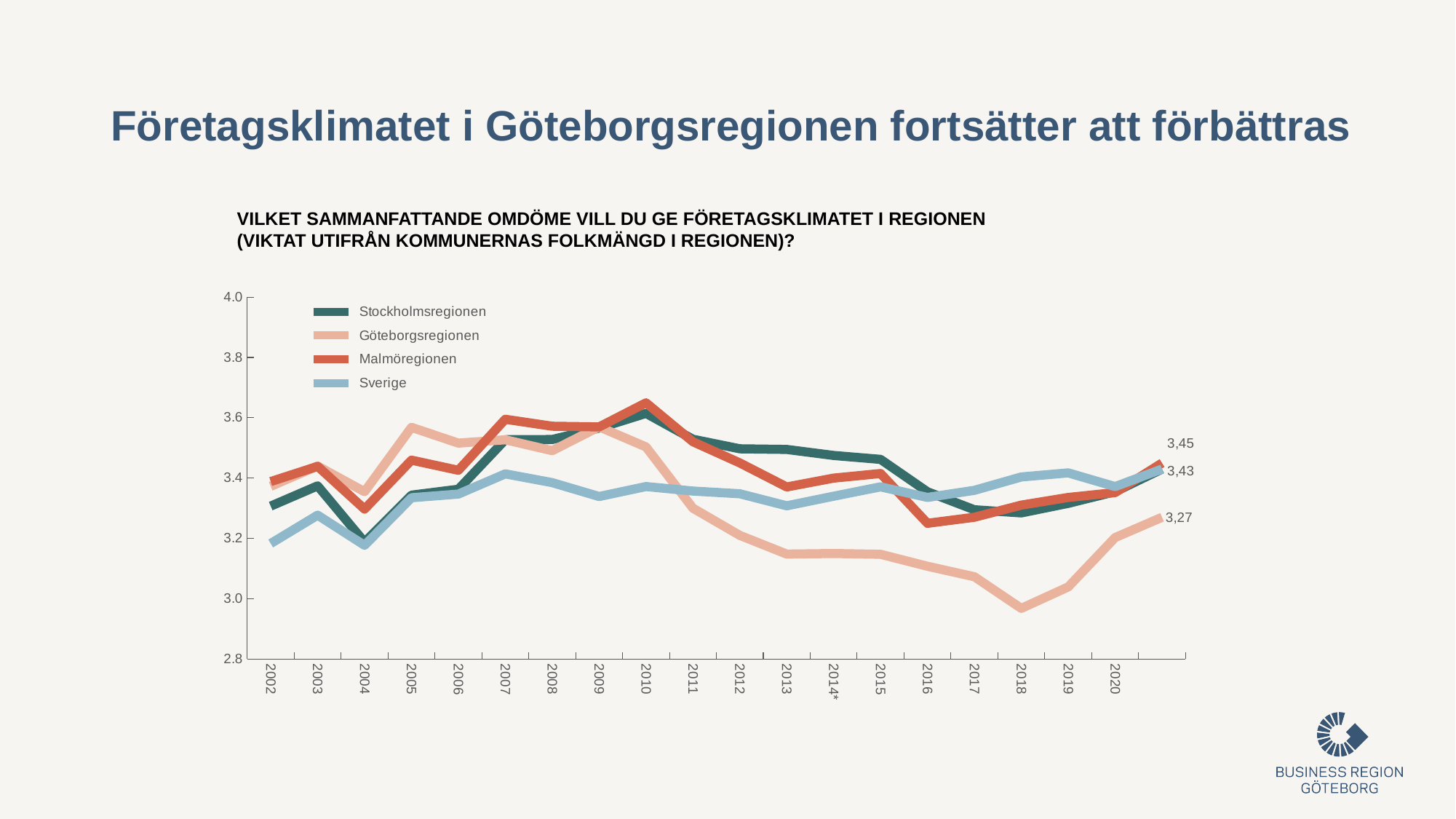
Is the value for Stockholmsregionen in 2004 greater or less than 3.4? less Does the Göteborgsregionen line rise or fall between 2010 and 2018? fall Is the value for Malmöregionen in 2010 greater or less than 3.6? greater How many series does the legend list? 4 Which series has the lowest value at the final point of the chart? Göteborgsregionen Which series has the highest value at the final point of the chart? Malmöregionen Is the value for Göteborgsregionen in 2018 greater or less than 3.0? less What is the labelled final value for Göteborgsregionen? 3,27 What kind of chart is shown on the slide? line chart What is the labelled final value for Malmöregionen? 3,45 In 2005, which is higher: Göteborgsregionen or Sverige? Göteborgsregionen What is the difference between the final labelled values for Malmöregionen (3,45) and Göteborgsregionen (3,27)? 0,18